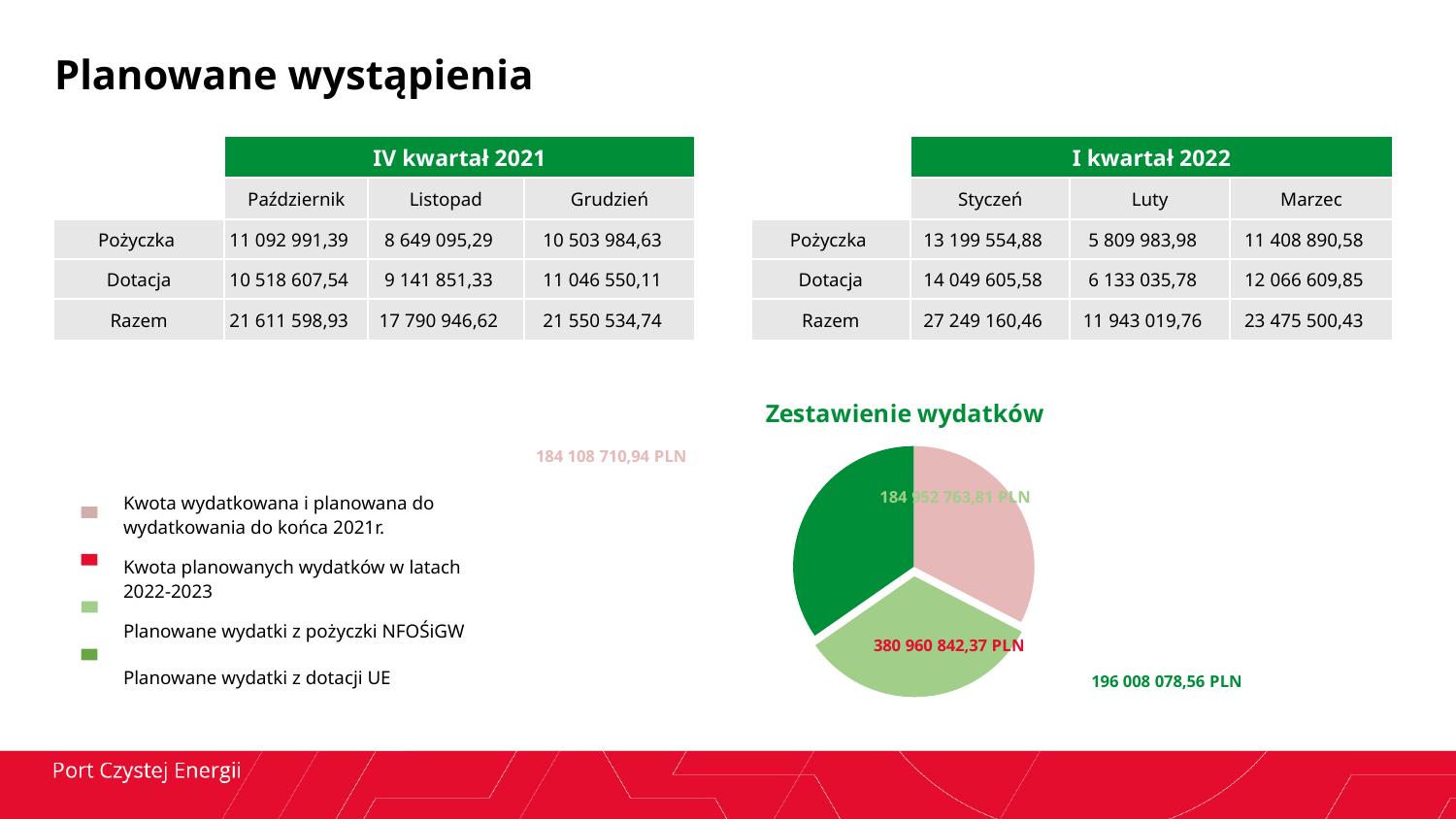
In the pie chart, what value is labelled for "Kwota wydatkowana i planowana do wydatkowania do końca 2021r."? 184 108 710,94 PLN In the pie chart, what value is labelled for "Kwota planowanych wydatków w latach 2022-2023"? 380 960 842,37 PLN In the pie chart, which is larger: the value for "Planowane wydatki z dotacji UE" or for "Planowane wydatki z pożyczki NFOŚiGW"? Planowane wydatki z dotacji UE Which legend entry of the pie chart is shown in dark green? Planowane wydatki z dotacji UE In the pie chart, what value is labelled for "Planowane wydatki z pożyczki NFOŚiGW"? 184 952 763,81 PLN How many entries does the legend of the pie chart list? 4 What is the title of the pie chart on the slide? Zestawienie wydatków In the pie chart, what is the difference between the value for "Planowane wydatki z dotacji UE" and the value for "Planowane wydatki z pożyczki NFOŚiGW"? 11 055 314,75 PLN In the pie chart, what value is labelled for "Planowane wydatki z dotacji UE"? 196 008 078,56 PLN What kind of chart is shown under the title "Zestawienie wydatków"? pie chart